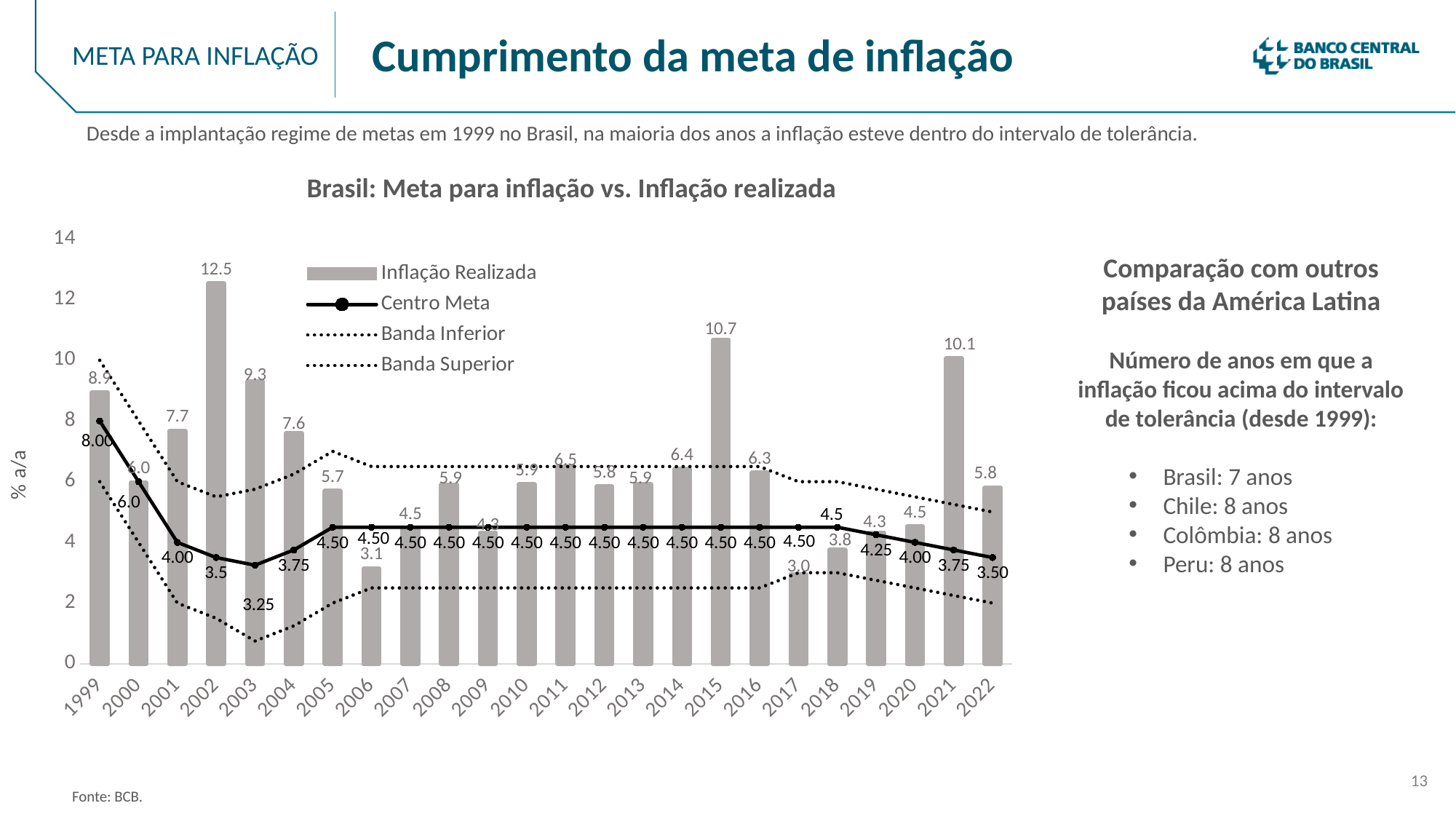
Is the Banda Inferior value for 2003 greater or less than 2? less What is the difference between the Inflação Realizada values for 2015 and 2016? 4.4 Which is larger, the Inflação Realizada for 2015 or for 2021? 2015 What is the Centro Meta value for 2022? 3.50 Is the Banda Superior value for 1999 greater or less than 8? greater What is the value of Inflação Realizada for 2002? 12.5 What is the Centro Meta value for 2003? 3.25 How many years are shown on the x axis of the chart? 24 Which year has the highest Inflação Realizada bar? 2002 Does the Centro Meta line rise or fall from 2019 to 2022? fall How many series does the chart legend list? 4 Which year has the lowest Inflação Realizada bar? 2017